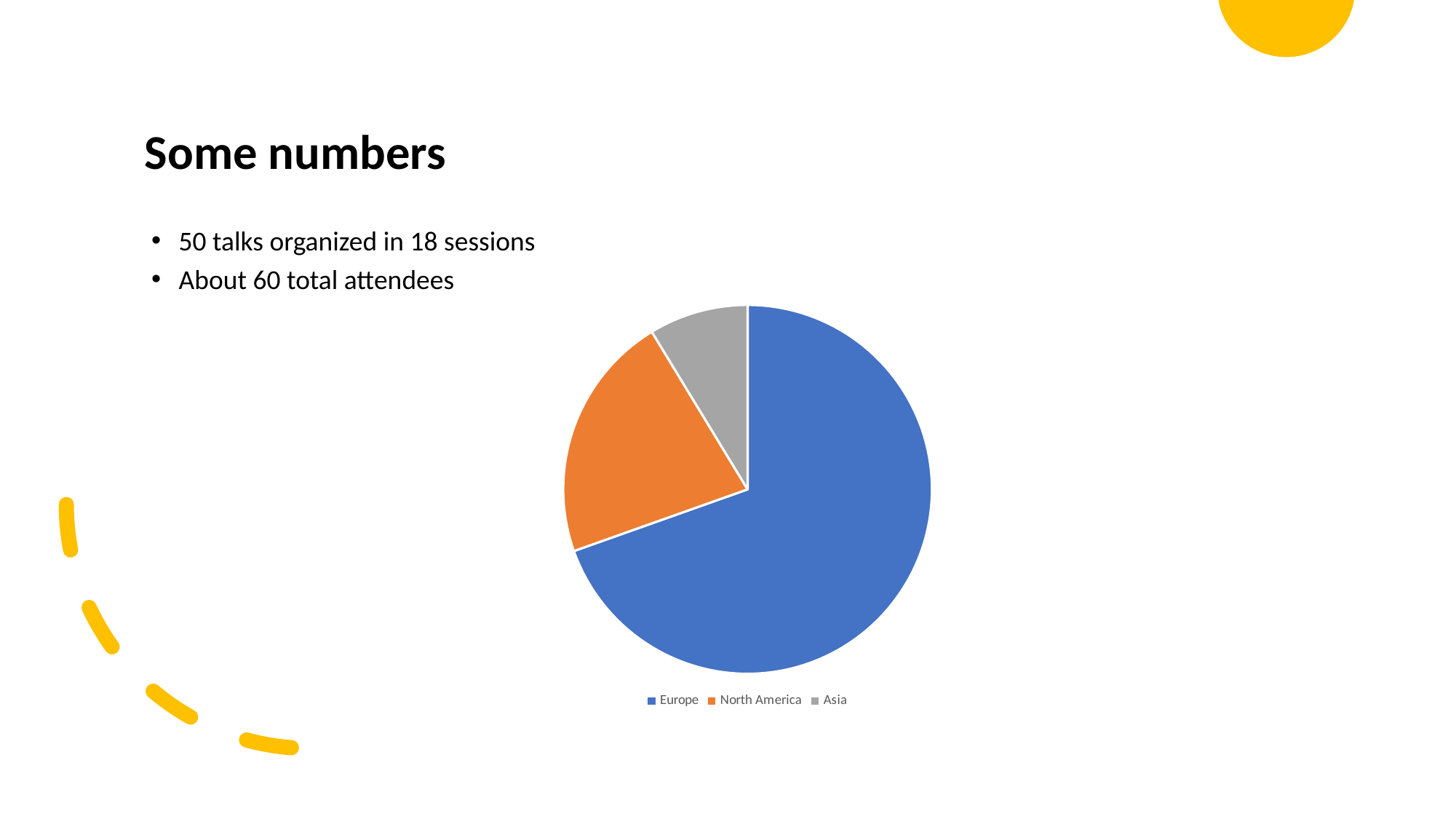
Which category is shown in orange in the pie chart? North America How many slices does the pie chart have? 3 How many entries does the legend of the pie chart list? 3 Which slice is larger in the pie chart, Europe or North America? Europe What kind of chart is shown on the slide? Pie chart Which slice is larger in the pie chart, North America or Asia? North America Which category has the largest slice in the pie chart? Europe What colour is the Europe slice in the pie chart? Blue Which category has the smallest slice in the pie chart? Asia Does Europe account for more or less than half of the pie chart? More